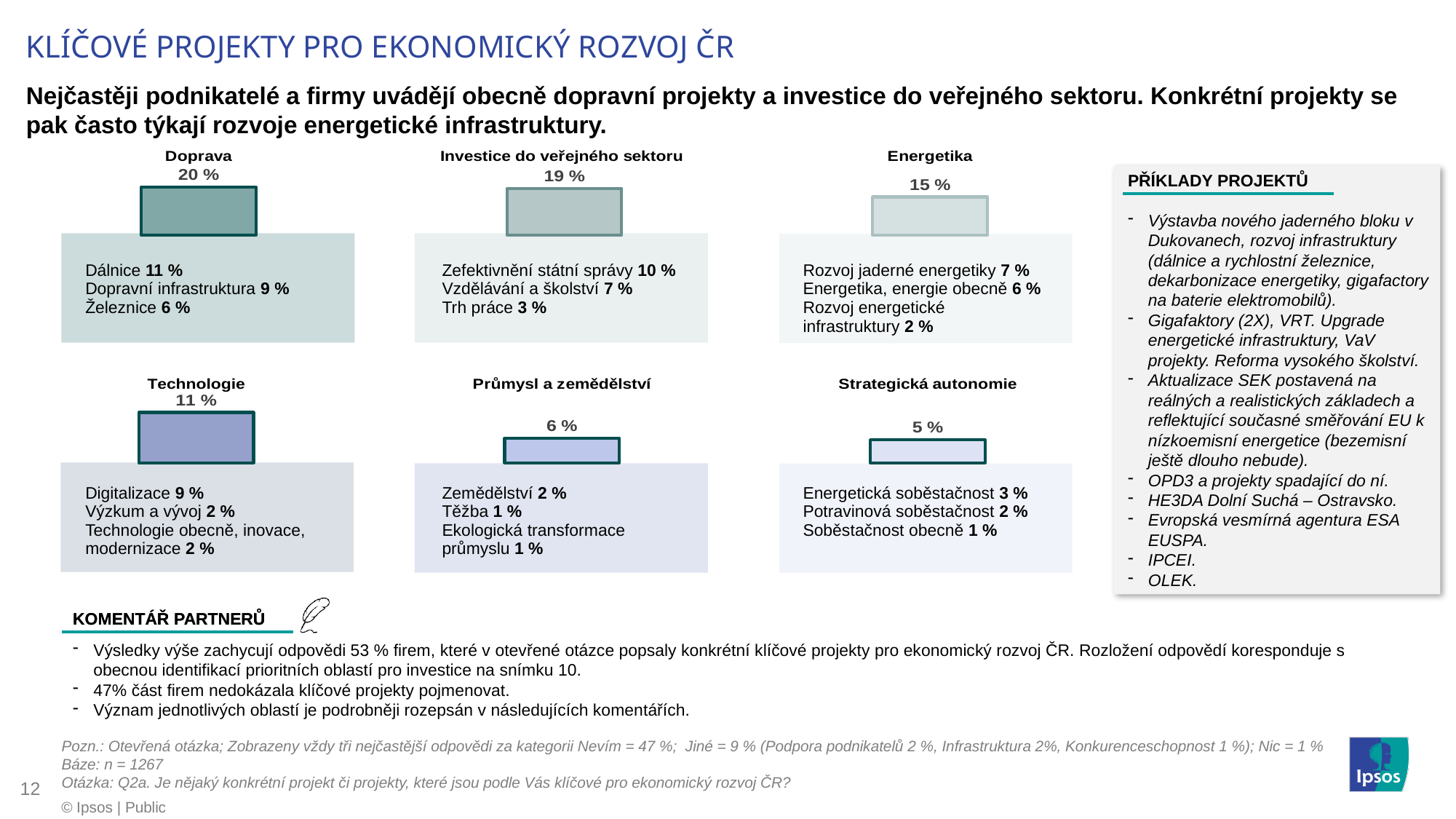
What percentage is shown for the Investice do veřejného sektoru bar? 19 % What percentage is shown for the Strategická autonomie bar? 5 % What percentage is shown for the Doprava bar? 20 % Which of the six categories has the highest percentage? Doprava What percentage is shown for the Energetika bar? 15 % Which of the six categories has the lowest percentage? Strategická autonomie What percentage is shown for the Technologie bar? 11 % What kind of chart is used to show the category percentages? Bar chart What is the difference in percentage points between Doprava and Energetika? 5 What is the difference in percentage points between Technologie and Průmysl a zemědělství? 5 Which is larger, the value for Energetika or the value for Technologie? Energetika How many category bars are shown on the slide? 6